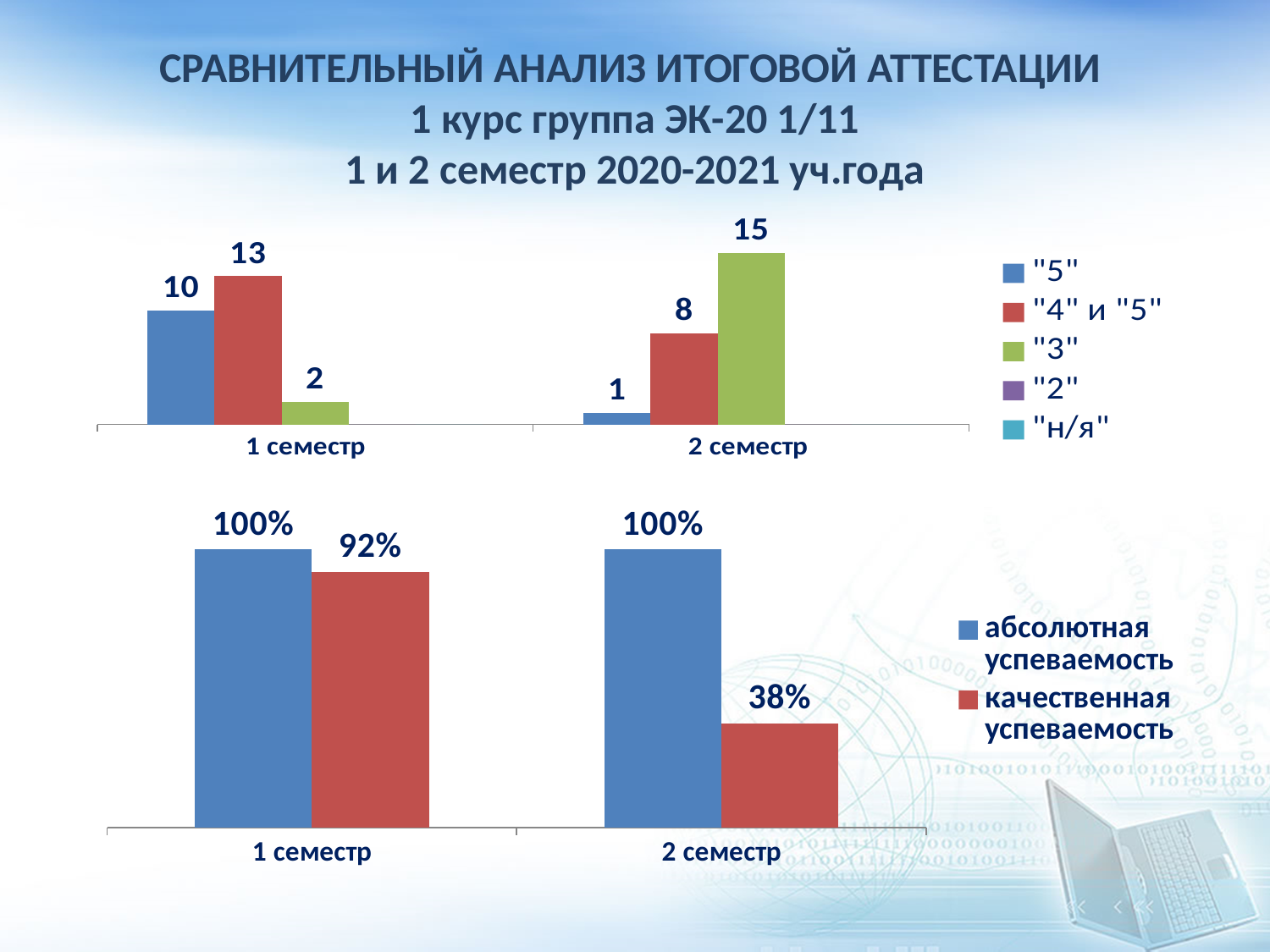
In the top chart, how many series does the legend list? 5 In the bottom chart, what is the difference between качественная успеваемость in 1 семестр and 2 семестр? 54% In the top chart, what is the value for "3" in 2 семестр? 15 What kind of chart is the bottom chart? bar chart In the bottom chart, what is the value for качественная успеваемость in 2 семестр? 38% In the top chart, what is the value for "4" и "5" in 2 семестр? 8 In the top chart, what is the value for "5" in 1 семестр? 10 In the top chart, what is the difference between the "5" values for 1 семестр and 2 семестр? 9 In the bottom chart, does качественная успеваемость rise or fall from 1 семестр to 2 семестр? fall In the bottom chart, what is the value for абсолютная успеваемость in 1 семестр? 100% In the top chart, which series has the highest value in 1 семестр? "4" и "5"